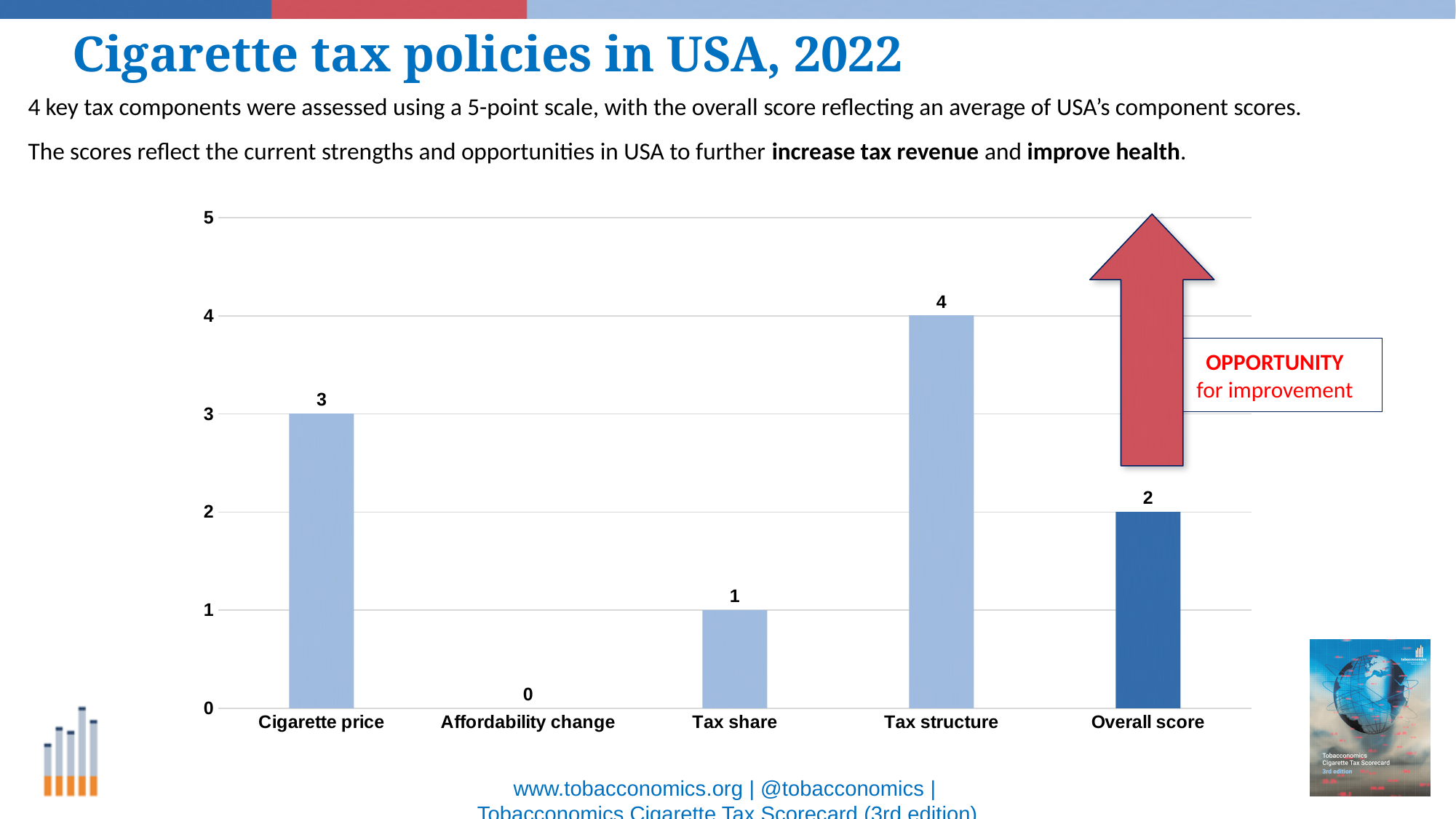
What is the difference between the values for Tax structure and Cigarette price? 1 Which is larger, the value for Cigarette price or the value for Tax share? Cigarette price What kind of chart is shown on the slide? Bar chart What is the value for Cigarette price? 3 Which category has the lowest value? Affordability change How many categories are shown on the x axis? 5 What is the value for Tax structure? 4 Which category has the highest value? Tax structure What is the value for Affordability change? 0 What is the value for Tax share? 1 What is the Overall score? 2 What is the maximum value shown on the y axis? 5